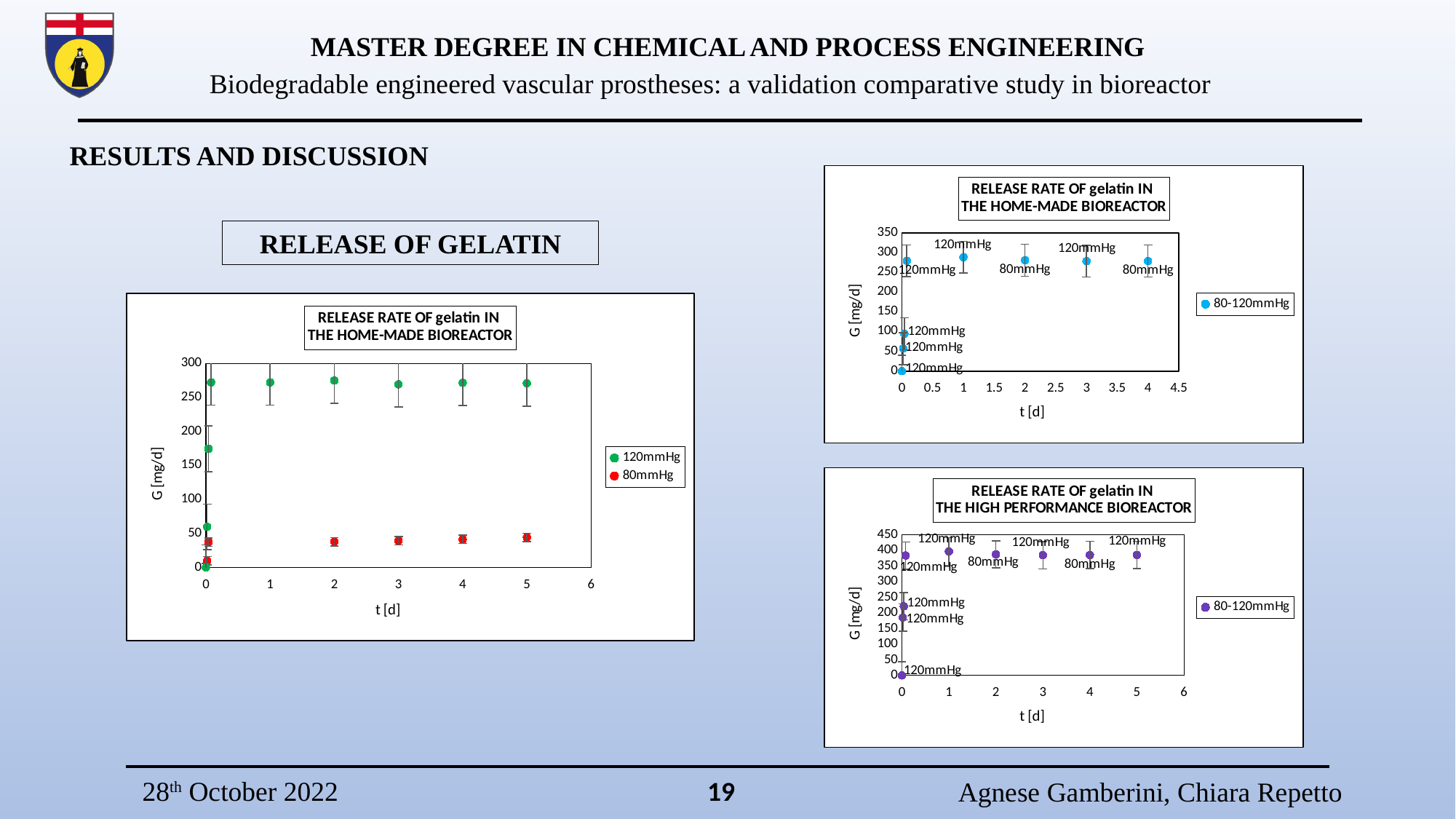
In the top-right chart, is the value at t = 1 d greater or less than 250? greater In the large chart on the left, is the 120mmHg value at t = 3 d greater or less than 200? greater In the bottom-right chart, is the value at t = 1 d greater or less than 350? greater In the large chart on the left, which colour represents the 80mmHg series? red What is the title of the bottom-right chart? RELEASE RATE OF gelatin IN THE HIGH PERFORMANCE BIOREACTOR How many series does the legend of the large chart on the left list? 2 What type of chart is the large chart on the left of the slide? scatter chart What is the y-axis label of the large chart on the left? G [mg/d] In the large chart on the left, which series has the larger value at t = 4 d, 120mmHg or 80mmHg? 120mmHg In the large chart on the left, do the 120mmHg values rise or fall between t = 0 d and t = 1 d? rise How many series does the legend of the top-right chart list? 1